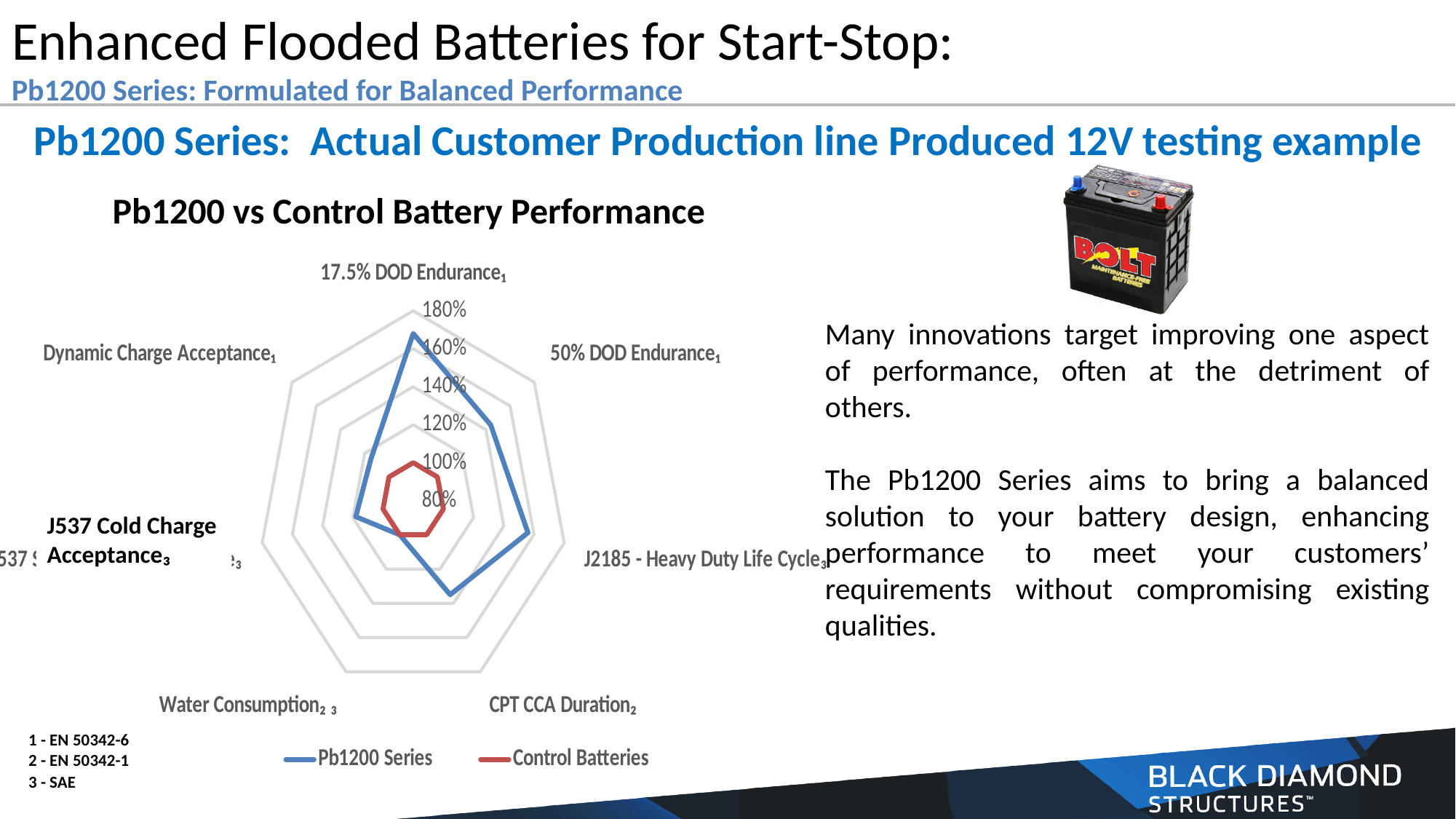
Which series has the larger value for J2185 - Heavy Duty Life Cycle, Pb1200 Series or Control Batteries? Pb1200 Series What colour is the Pb1200 Series line on the radar chart? Blue How many performance categories (axes) are plotted on the Pb1200 vs Control Battery Performance chart? 7 Is the Pb1200 Series value for Water Consumption greater or less than 140%? less Is the Pb1200 Series value for 17.5% DOD Endurance greater or less than 140%? greater Is the Pb1200 Series value for CPT CCA Duration greater or less than 100%? greater What is the title of the radar chart on the slide? Pb1200 vs Control Battery Performance How many series does the legend of the Pb1200 vs Control Battery Performance chart list? 2 What kind of chart is used to show Pb1200 vs Control Battery Performance? Radar chart On which category does the Pb1200 Series reach its highest value? 17.5% DOD Endurance